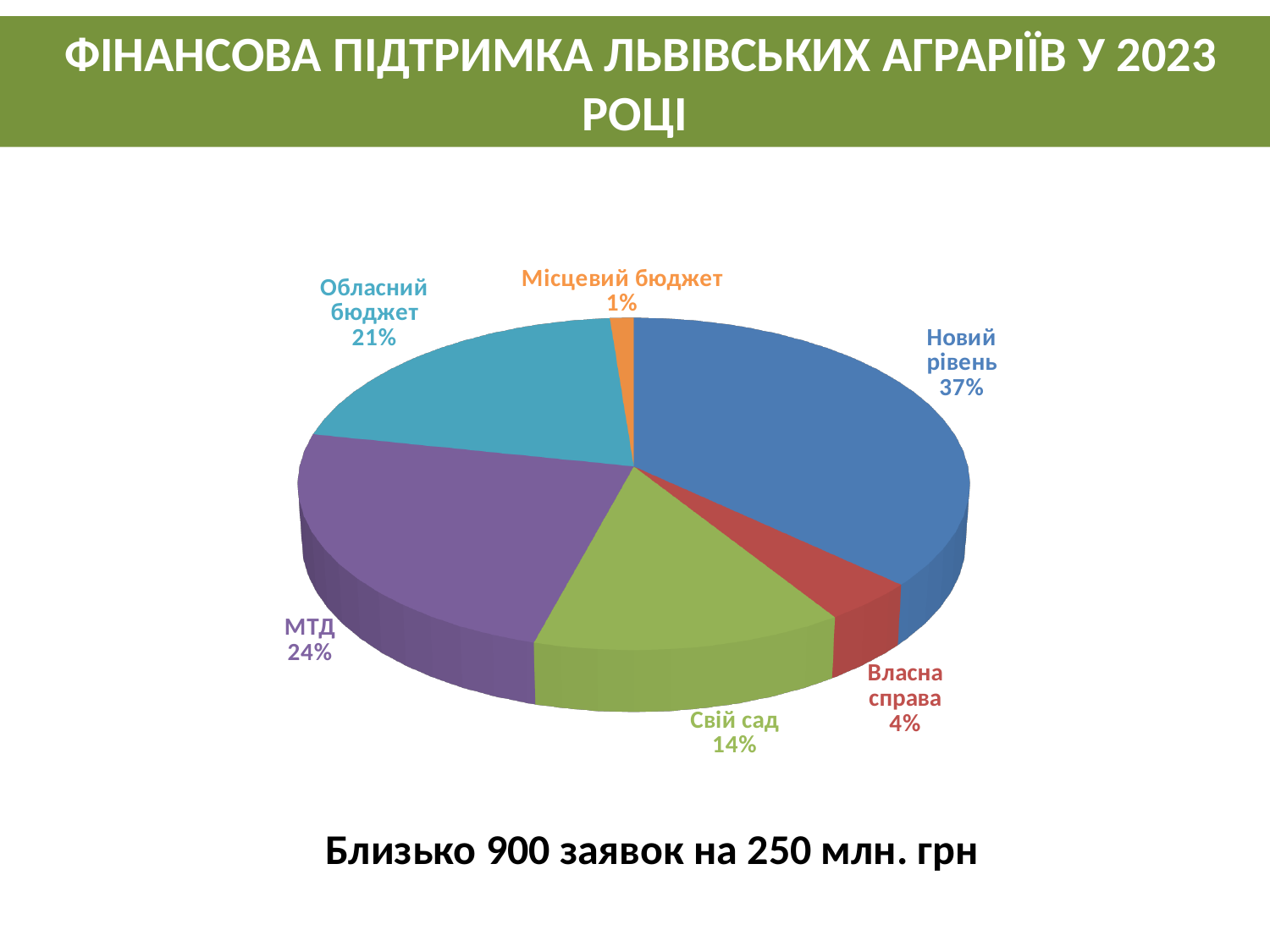
What is the difference in percentage points between Новий рівень and МТД? 13 What share of the pie does Власна справа have? 4% What share of the pie does МТД have? 24% What share of the pie does Новий рівень have? 37% Which is larger, the share for Обласний бюджет or the share for Свій сад? Обласний бюджет What kind of chart is shown on the slide? Pie chart How many slices does the pie chart have? 6 Which category has the smallest slice of the pie? Місцевий бюджет Which category has the largest slice of the pie? Новий рівень